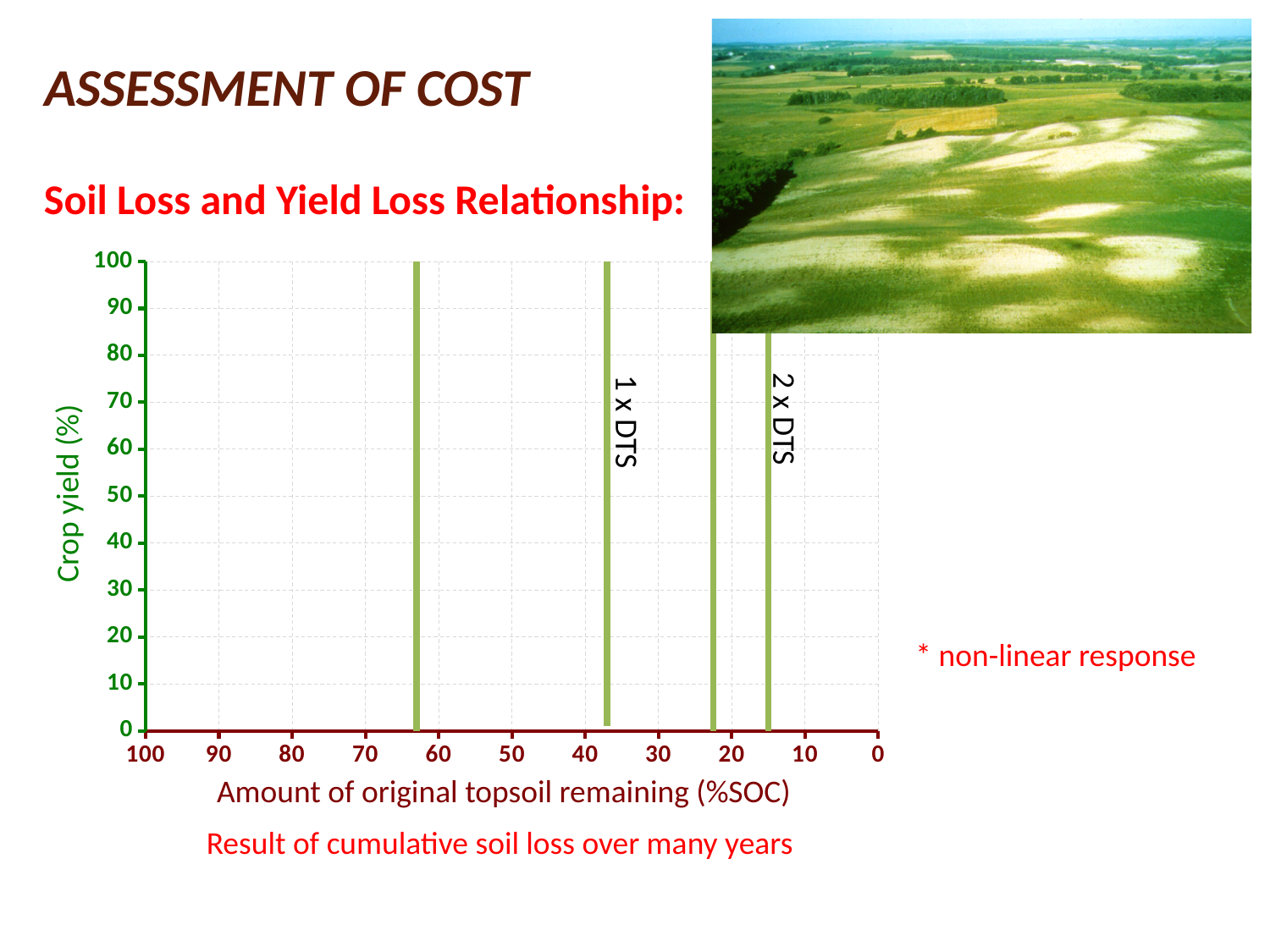
Is the topsoil-remaining value at the line labelled "1 x DTS" greater or less than 50? less Which vertical line is at a higher amount of original topsoil remaining, the one labelled "1 x DTS" or the one labelled "2 x DTS"? 1 x DTS How many vertical green marker lines are drawn on the chart? 4 Is the topsoil-remaining value at the line labelled "2 x DTS" greater or less than 20? less What is the title of the x axis of the chart? Amount of original topsoil remaining (%SOC) Is the topsoil-remaining value at the leftmost vertical green line greater or less than 70? less What is the title of the y axis of the chart? Crop yield (%)